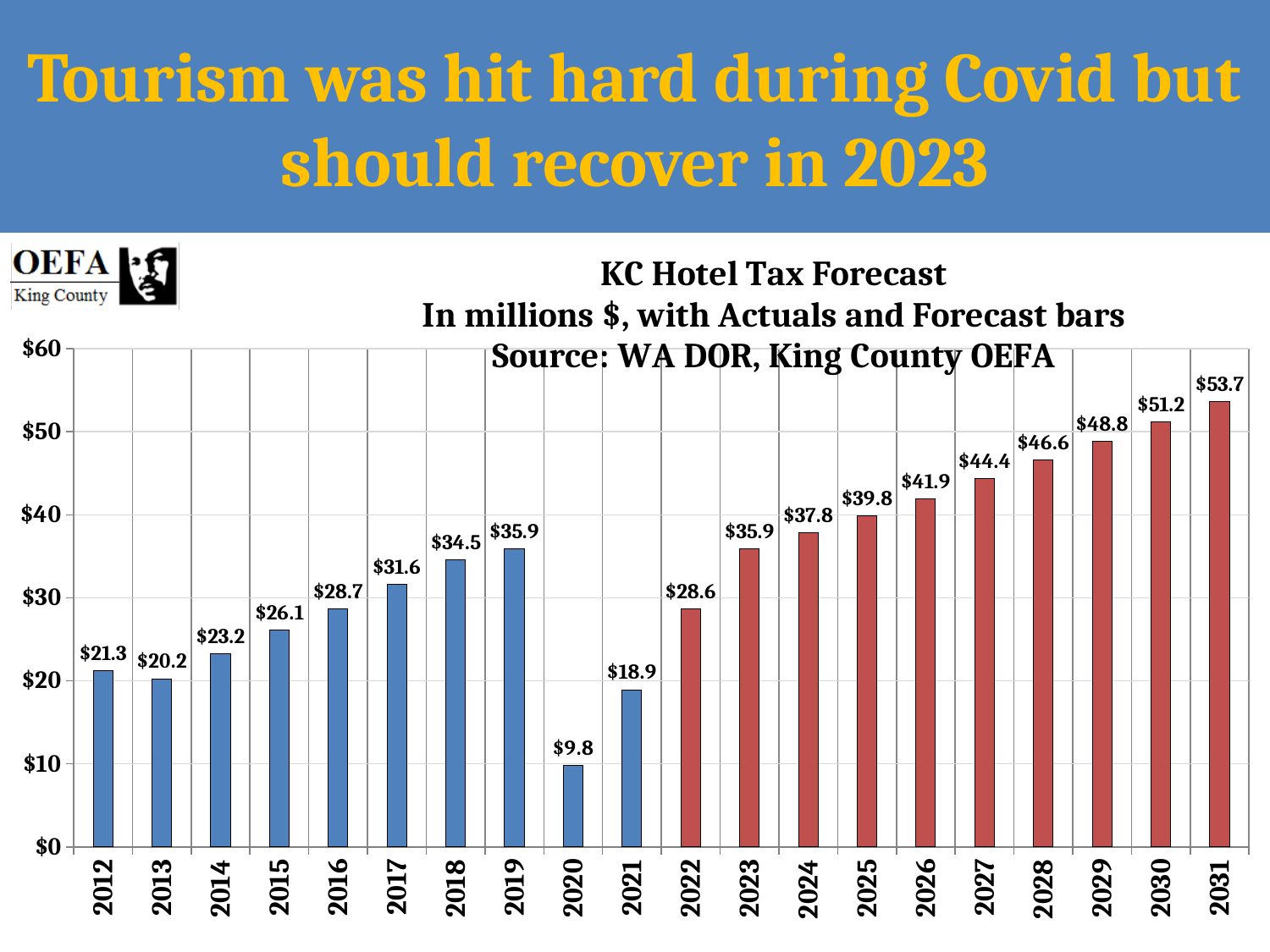
What is the difference between the values for 2021 and 2020? $9.1 Which year has the lowest value? 2020 What is the value for 2020? $9.8 What is the value for 2022? $28.6 Is the value for 2030 greater or less than $50? greater Which year has the highest value? 2031 How many years are shown on the x axis? 20 Which is larger, the value for 2018 or the value for 2024? 2024 What is the title of the chart? KC Hotel Tax Forecast What is the value for 2031? $53.7 Which is larger, the value for 2019 or the value for 2023? They are equal ($35.9) What kind of chart is this? Bar chart